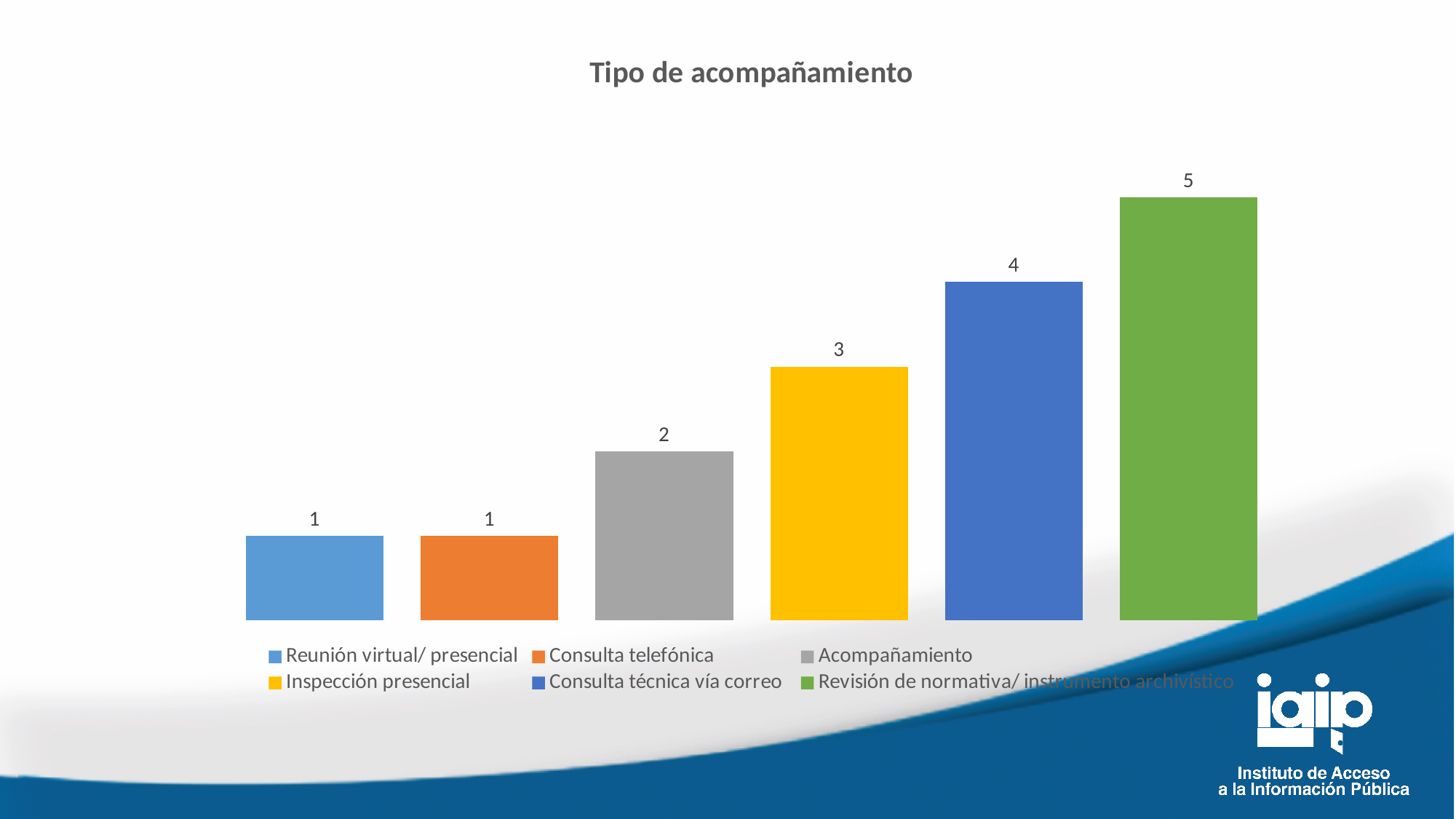
How many entries does the legend list? 6 Which is larger, the value for Inspección presencial or the value for Consulta telefónica? Inspección presencial What is the value for Inspección presencial? 3 Which category has the highest value? Revisión de normativa/ instrumento archivístico What is the value for Acompañamiento? 2 How many categories are shown in the chart? 6 What kind of chart is shown on the slide? Bar chart What is the title of the chart? Tipo de acompañamiento What is the value for Consulta técnica vía correo? 4 What is the difference between the values for Revisión de normativa/ instrumento archivístico and Acompañamiento? 3 Do the values rise or fall from left to right across the chart? Rise What is the value for Revisión de normativa/ instrumento archivístico? 5